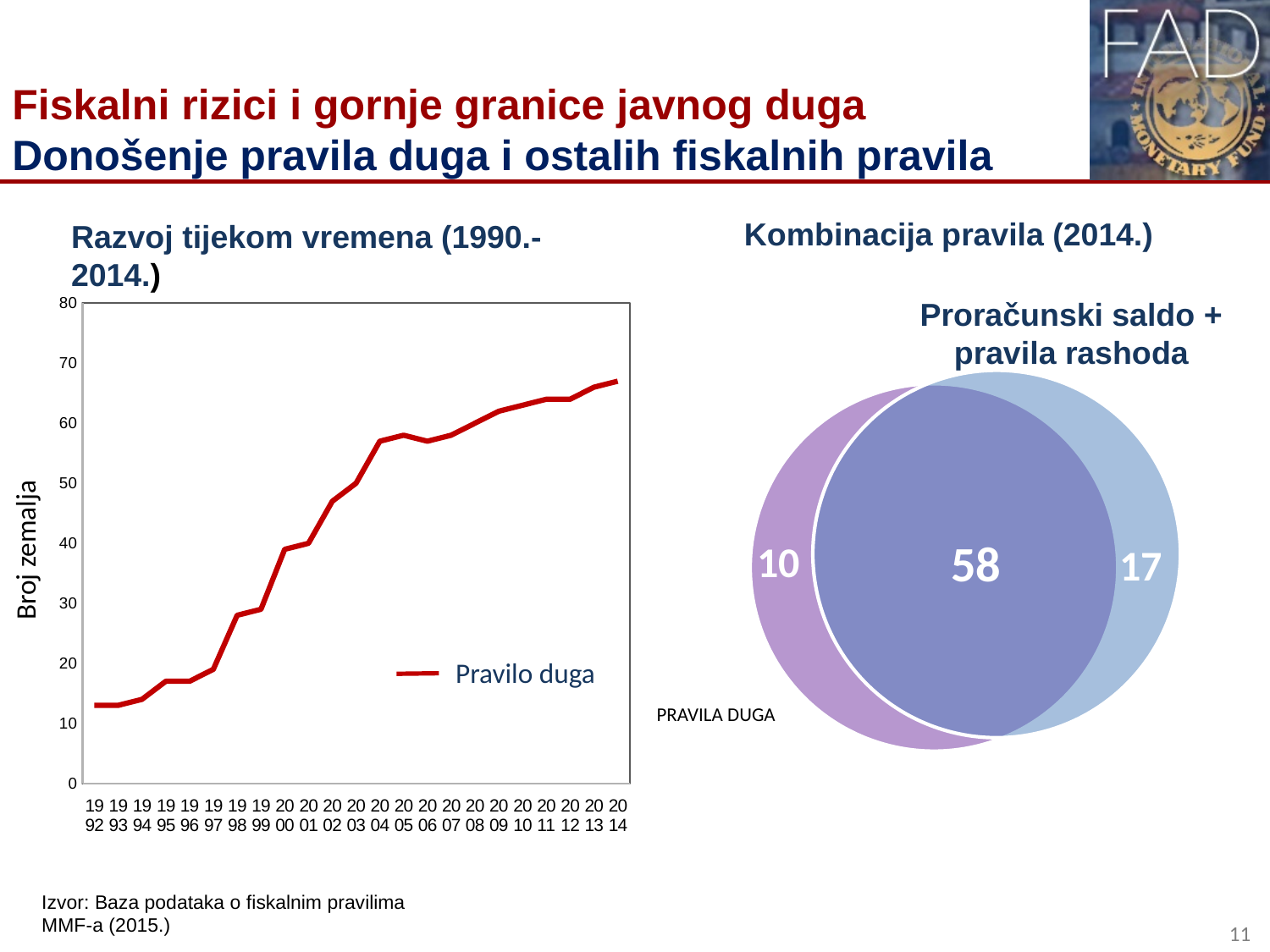
On the left chart 'Razvoj tijekom vremena (1990.-2014.)', what is the name of the series shown in the legend? Pravilo duga On the left chart 'Razvoj tijekom vremena (1990.-2014.)', is the value for 2014 greater or less than 60? greater On the right diagram 'Kombinacija pravila (2014.)', how many countries are in the overlap of the two circles? 58 On the left chart 'Razvoj tijekom vremena (1990.-2014.)', do the values generally rise or fall from 1992 to 2014? rise On the left chart 'Razvoj tijekom vremena (1990.-2014.)', how many series does the legend list? 1 On the left chart 'Razvoj tijekom vremena (1990.-2014.)', is the value for 1998 greater or less than 20? greater On the right diagram 'Kombinacija pravila (2014.)', which is larger: the number with only 'Proračunski saldo + pravila rashoda' (17) or the number with only 'PRAVILA DUGA' (10)? Proračunski saldo + pravila rashoda On the left chart 'Razvoj tijekom vremena (1990.-2014.)', what kind of chart is it? line chart On the right diagram 'Kombinacija pravila (2014.)', how many countries have only a debt rule (PRAVILA DUGA) without the other rules? 10 On the left chart 'Razvoj tijekom vremena (1990.-2014.)', what is the label of the vertical axis? Broj zemalja On the left chart 'Razvoj tijekom vremena (1990.-2014.)', is the value for 2004 greater or less than 50? greater